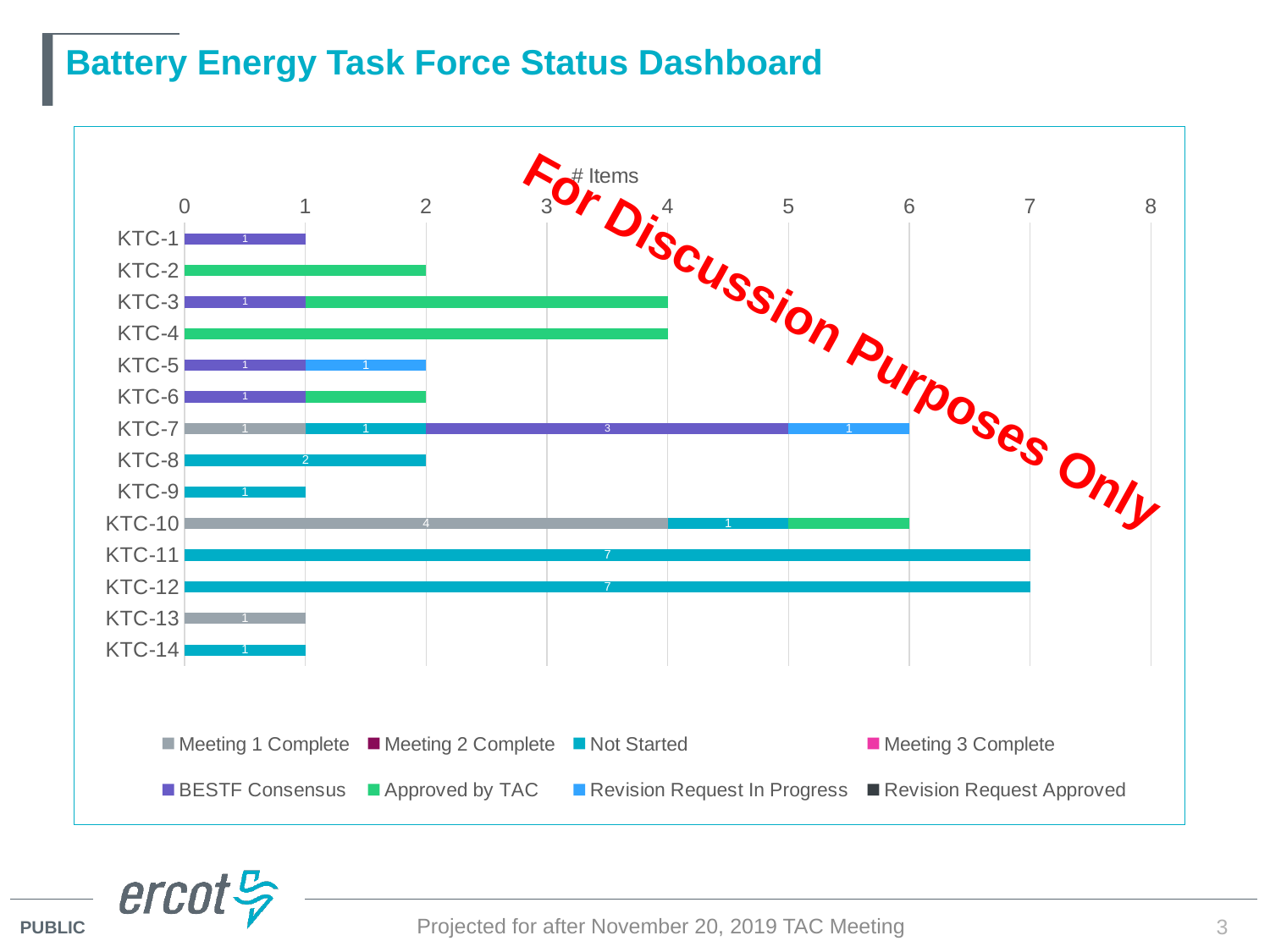
Which has the larger Not Started value, KTC-8 or KTC-9? KTC-8 What is the BESTF Consensus value for KTC-7? 3 How many series does the chart legend list? 8 What is the Meeting 1 Complete value for KTC-10? 4 What is the total number of items for KTC-7 across all segments? 6 What is the difference between the Meeting 1 Complete value for KTC-10 and the Meeting 1 Complete value for KTC-13? 3 What is the Not Started value for KTC-8? 2 What is the Not Started value for KTC-11? 7 What is the title shown above the chart's axis? # Items What type of chart is shown on the slide? Stacked bar chart How many KTC categories are plotted on the chart? 14 Is the total bar length for KTC-4 greater or less than 3? greater